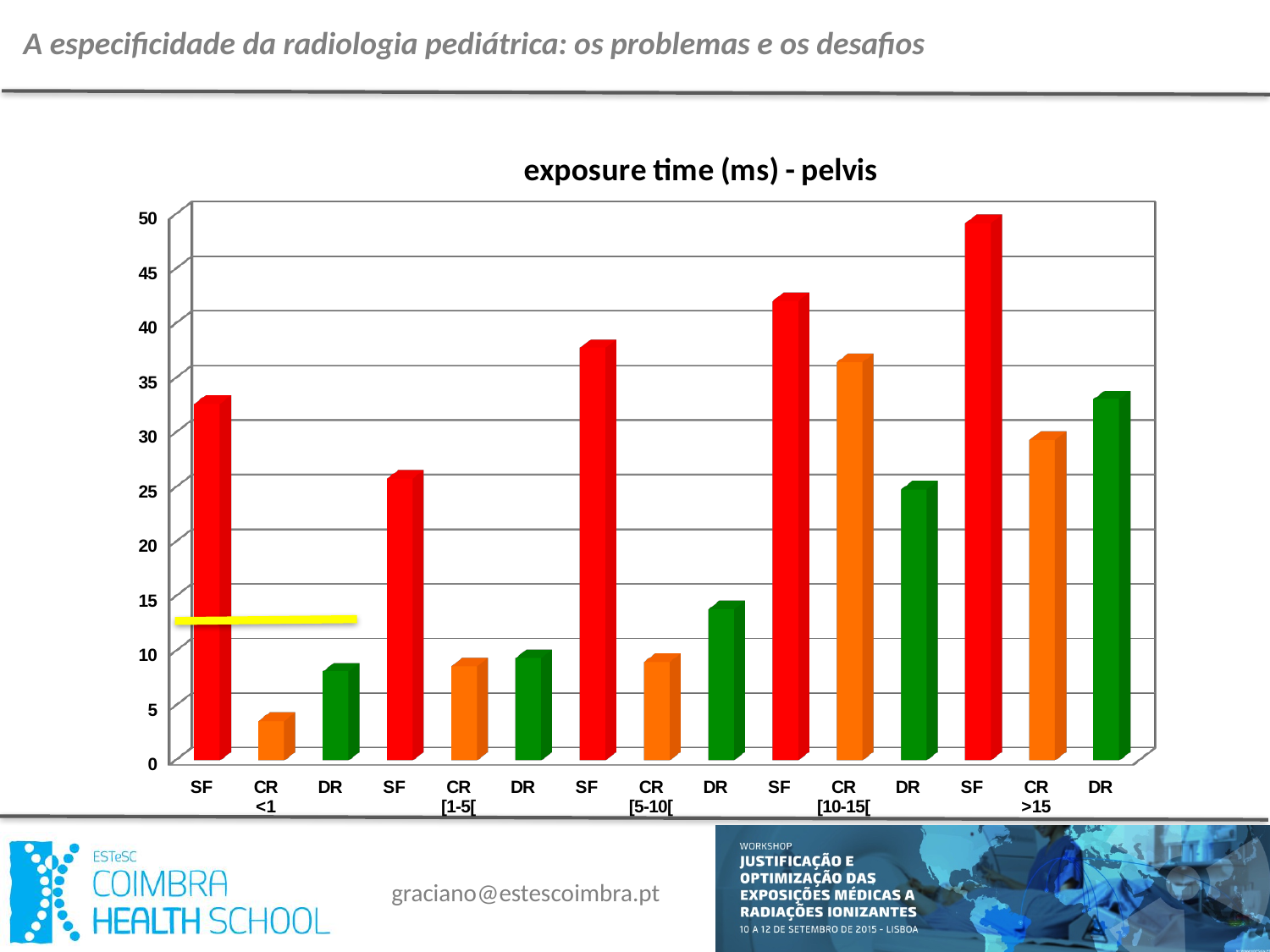
Do the DR values rise or fall as the age groups go from <1 to >15? rise Is the value for SF in the <1 group greater or less than 30? greater How many age groups are shown along the x axis? 5 Which bar has the highest exposure time in the chart? SF in the >15 group How many bars are plotted in the chart? 15 What kind of chart is shown on the slide? bar chart Is the value for CR in the [10-15[ group greater or less than 35? greater Which is larger in the >15 group, the CR bar or the DR bar? DR Which is larger in the [10-15[ group, the SF bar or the DR bar? SF Which bar has the lowest exposure time in the chart? CR in the <1 group What is the title of the chart? exposure time (ms) - pelvis Is the value for CR in the <1 group greater or less than 5? less